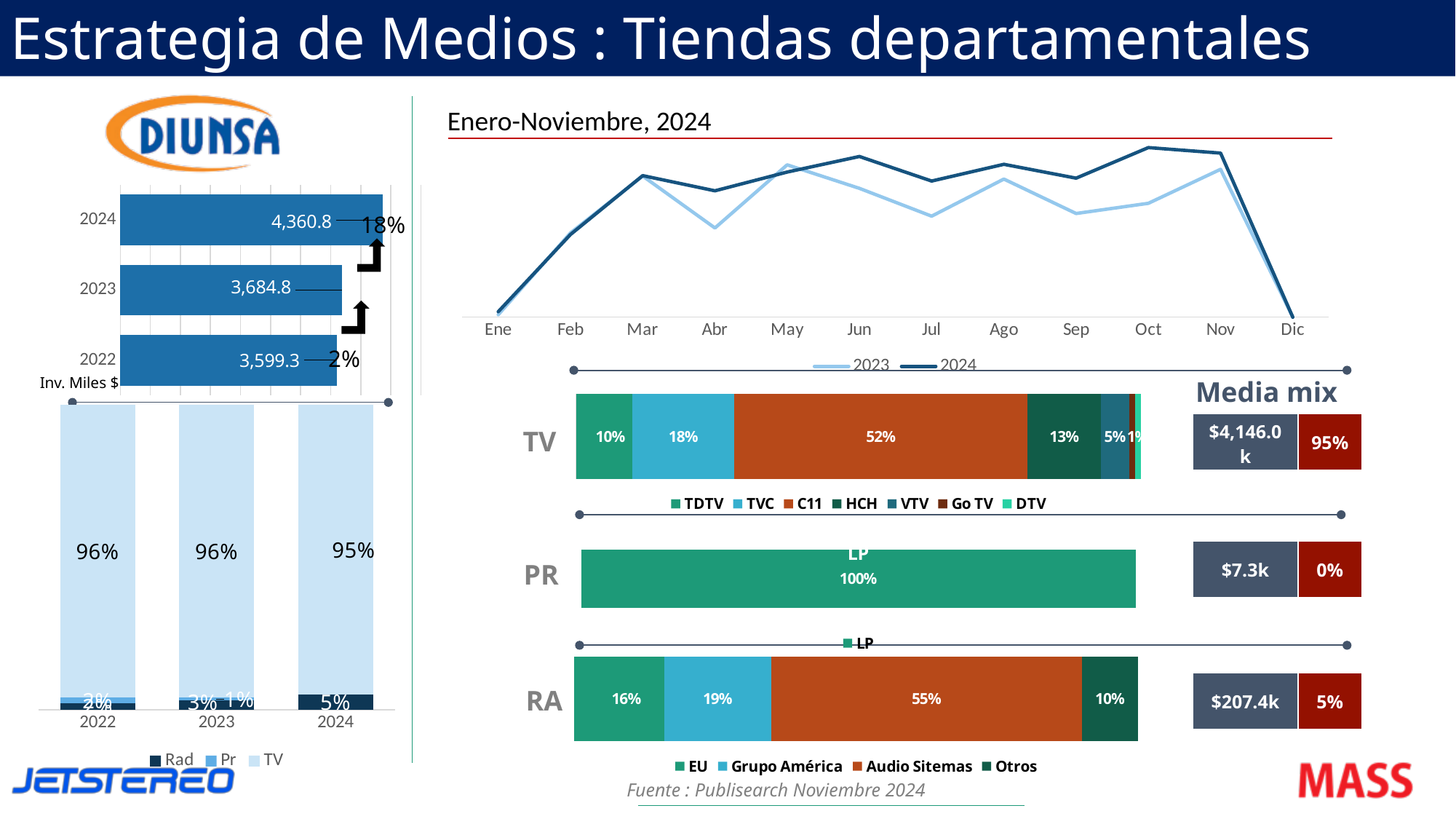
In the line chart titled 'Enero-Noviembre, 2024', which series is higher in Jun, 2023 or 2024? 2024 In the top-left bar chart of investment by year, what is the value for 2024? 4,360.8 In the line chart titled 'Enero-Noviembre, 2024', how many series does the legend list? 2 In the line chart titled 'Enero-Noviembre, 2024', how many months are shown on the x axis? 12 In the TV stacked bar on the right, which channel has the largest share? C11 In the TV stacked bar on the right, what is the share for C11? 52% In the top-left bar chart of investment by year, what is the difference between the 2024 and 2023 values? 676.0 What kind of chart is the top-left chart showing investment by year? bar chart In the RA stacked bar on the right, what is the share for Audio Sitemas? 55% In the bottom-left stacked bar chart, what is the TV share for 2024? 95% In the top-left bar chart of investment by year, which year has the highest value? 2024 In the top-left bar chart of investment by year, what is the value for 2022? 3,599.3